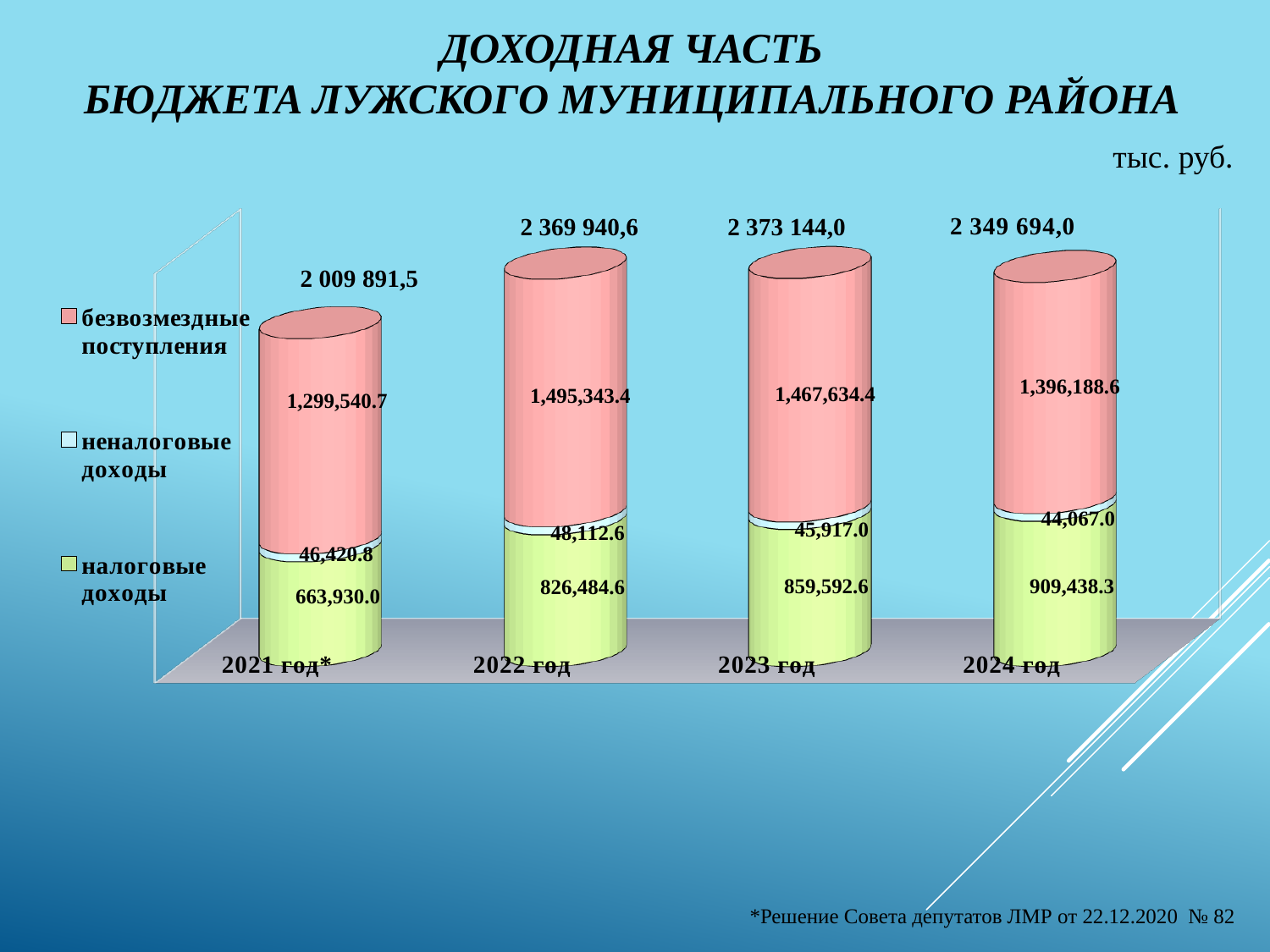
How many series does the legend list? 3 What is the total printed above the bar for 2023 год? 2 373 144,0 How many years are shown on the chart? 4 What is the value of неналоговые доходы for 2021 год*? 46,420.8 What is the value of безвозмездные поступления for 2024 год? 1,396,188.6 Which is larger: безвозмездные поступления in 2022 год or in 2023 год? 2022 год Which year has the lowest value for неналоговые доходы? 2024 год Which year has the highest value for налоговые доходы? 2024 год Do the values for налоговые доходы rise or fall from 2021 to 2024? Rise What kind of chart is shown on the slide? Stacked bar chart What is the difference between налоговые доходы in 2024 год and 2021 год*? 245,508.3 What is the value of налоговые доходы for 2022 год? 826,484.6